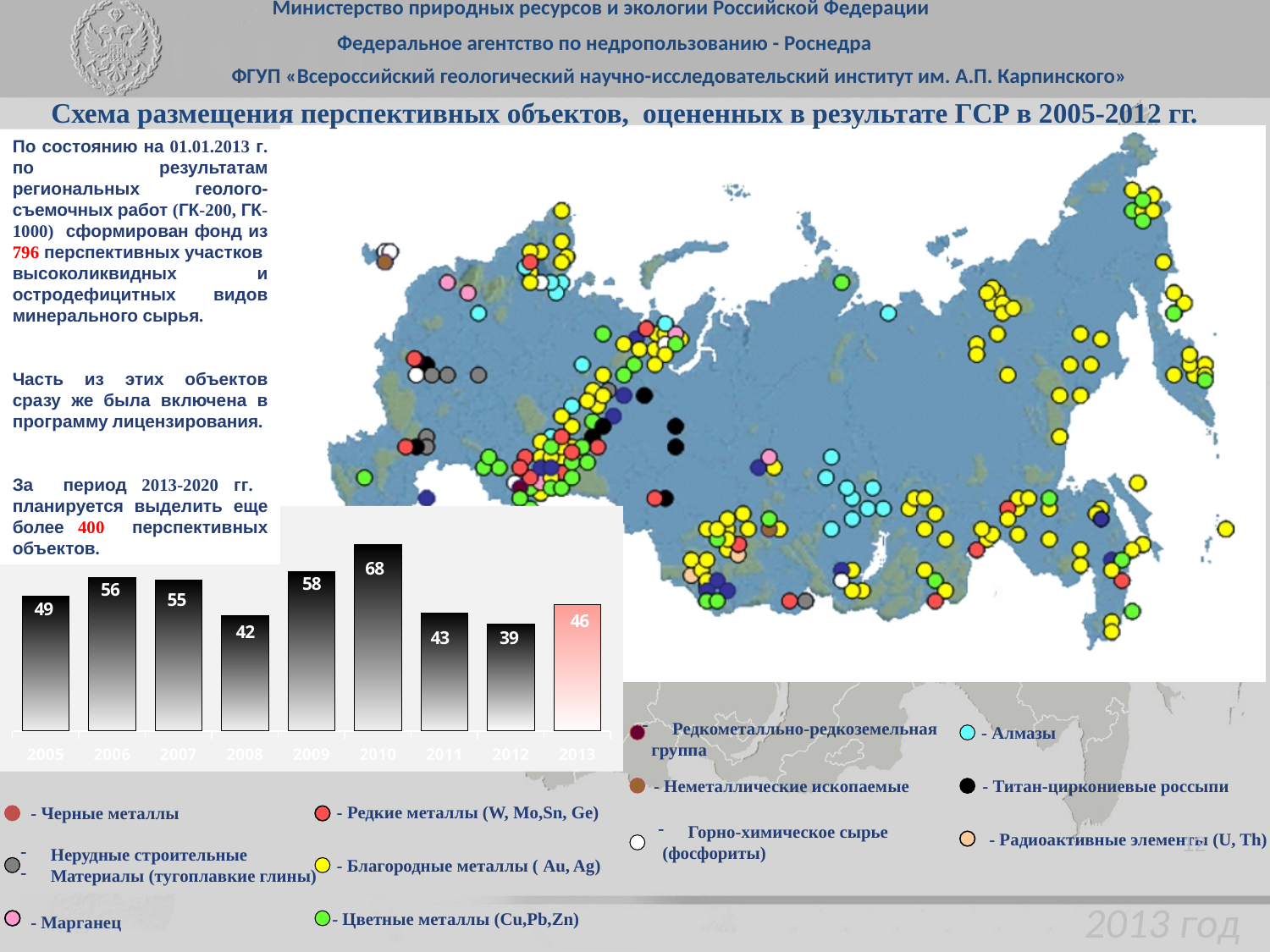
In the bar chart, which year has the highest value? 2010 How many bars (years) are shown in the bar chart? 9 In the bar chart, which bar is coloured differently (pink) from the others? 2013 What type of chart is shown in the lower left of the slide? bar chart In the bar chart, what is the difference between the values for 2009 and 2008? 16 In the bar chart, what is the value for 2012? 39 In the bar chart, which is larger, the value for 2006 or the value for 2007? 2006 In the bar chart, what is the difference between the values for 2010 and 2012? 29 In the bar chart, what is the value for 2010? 68 In the bar chart, what is the value for 2013? 46 In the bar chart, what is the value for 2005? 49 In the bar chart, which year has the lowest value? 2012